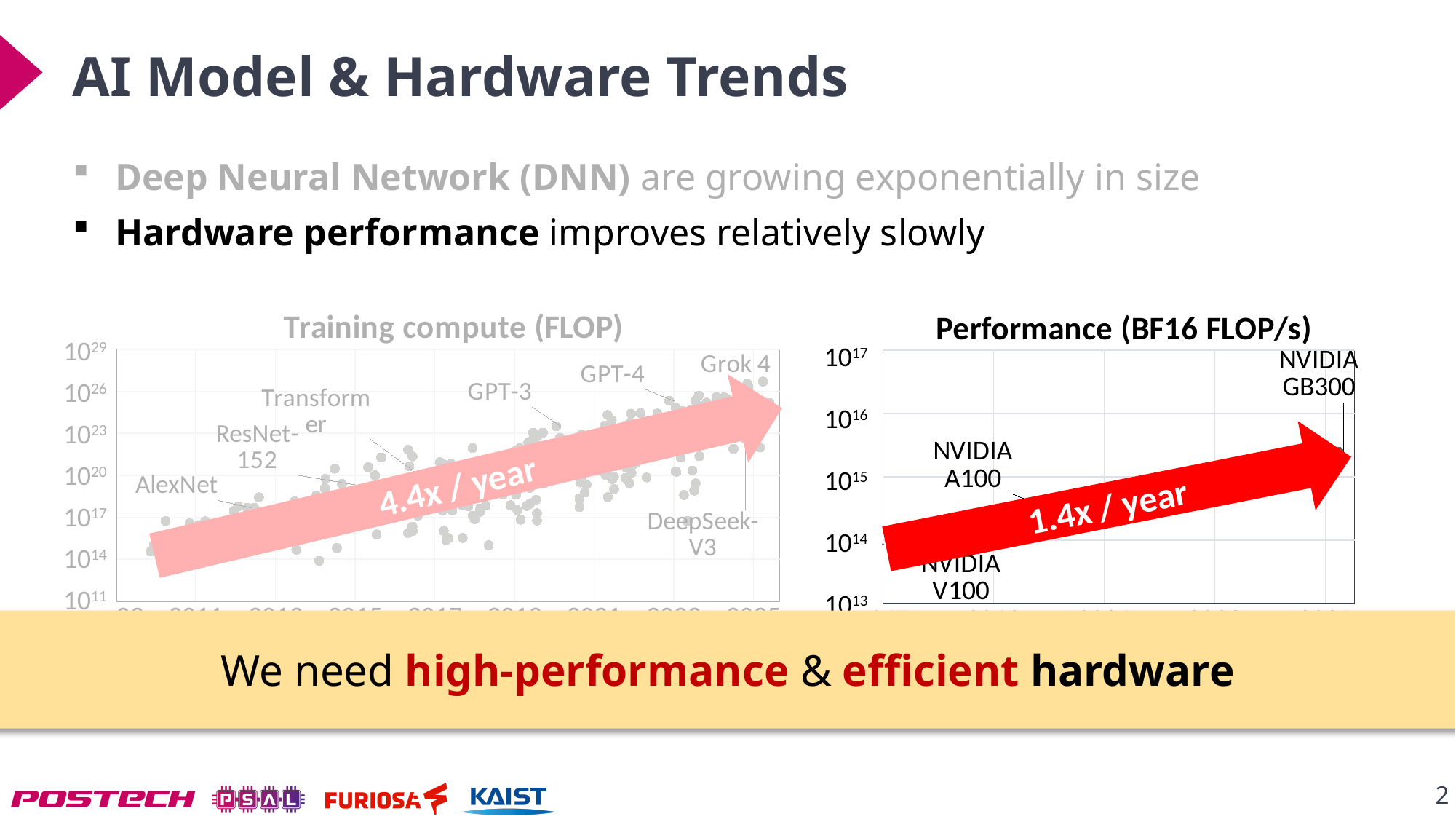
In the 'Training compute (FLOP)' chart, do the values rise or fall as the years increase along the x axis? rise In the 'Performance (BF16 FLOP/s)' chart, which has higher performance, NVIDIA GB300 or NVIDIA V100? NVIDIA GB300 In the 'Performance (BF16 FLOP/s)' chart, is the value for NVIDIA GB300 greater or less than 10^16? less In the 'Training compute (FLOP)' chart, is the training compute for GPT-4 greater or less than 10^23? greater What is the title of the chart on the right side of the slide? Performance (BF16 FLOP/s) In the 'Performance (BF16 FLOP/s)' chart, do the values rise or fall over time along the x axis? rise In the 'Performance (BF16 FLOP/s)' chart, what annual growth rate is written on the arrow? 1.4x / year In the 'Training compute (FLOP)' chart, which of the labeled models has the highest training compute? Grok 4 What kind of chart is the 'Training compute (FLOP)' chart on the left? scatter chart In the 'Training compute (FLOP)' chart, which of the labeled models has the lowest training compute? AlexNet How many NVIDIA GPUs are labeled in the 'Performance (BF16 FLOP/s)' chart? 3 In the 'Training compute (FLOP)' chart, what annual growth rate is written on the arrow? 4.4x / year